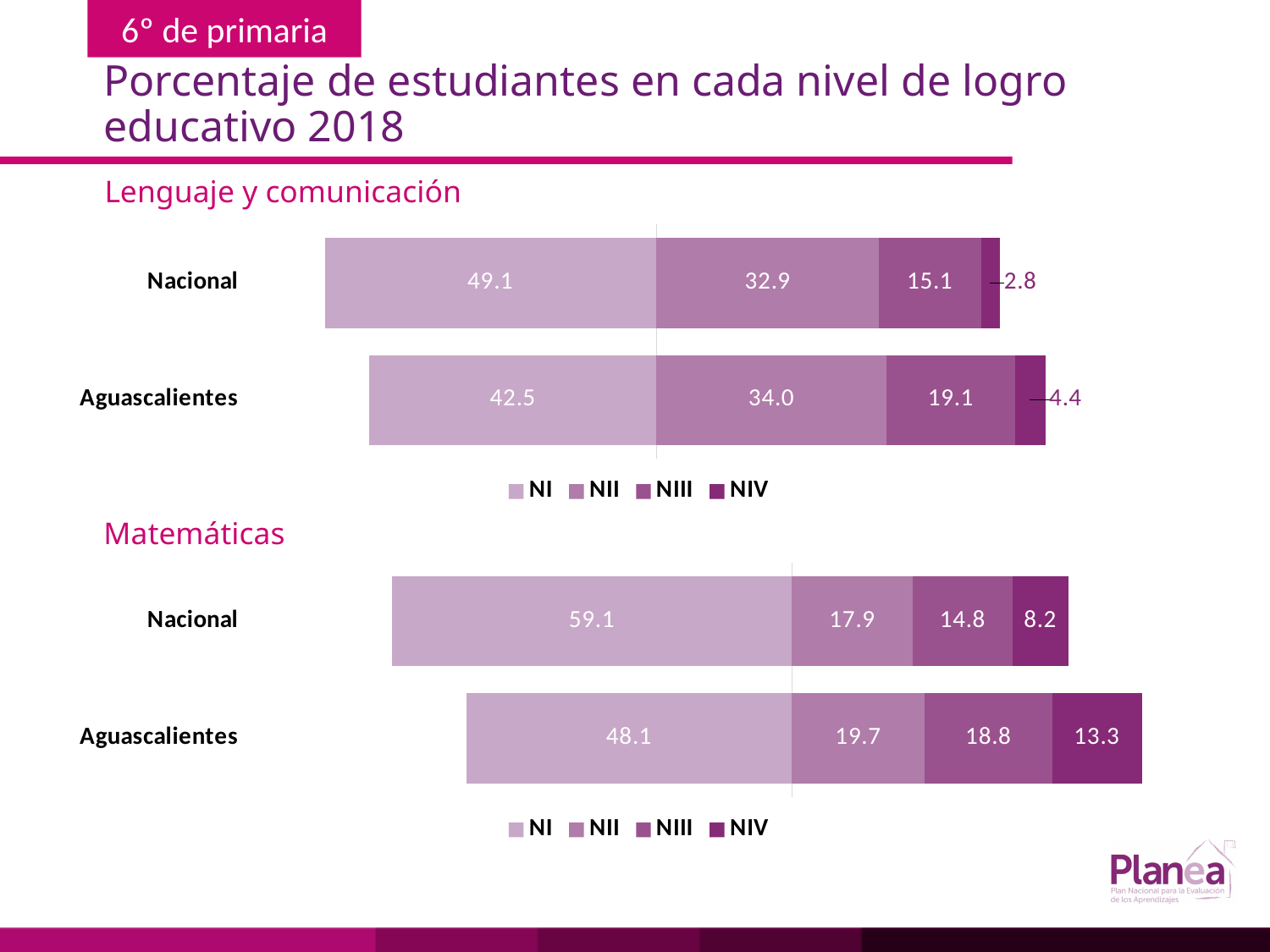
How many categories are shown in the Lenguaje y comunicación chart? 2 In the Lenguaje y comunicación chart, what is the total of the stacked bar for Aguascalientes? 100.0 In the Matemáticas chart, which category has the higher NI value, Nacional or Aguascalientes? Nacional In the Matemáticas chart, what is the NII value for Aguascalientes? 19.7 In the Lenguaje y comunicación chart, what is the NIV value for Aguascalientes? 4.4 What kind of chart is the Lenguaje y comunicación chart? Stacked bar chart In the Matemáticas chart, what is the difference between the NI values for Nacional and Aguascalientes? 11.0 In the Matemáticas chart, what is the total of the stacked bar for Nacional? 100.0 How many series does the legend of the Matemáticas chart list? 4 In the Lenguaje y comunicación chart, what is the NI value for Nacional? 49.1 In the Lenguaje y comunicación chart, what is the difference between the NIII values for Aguascalientes and Nacional? 4.0 In the Matemáticas chart, what is the NIV value for Nacional? 8.2